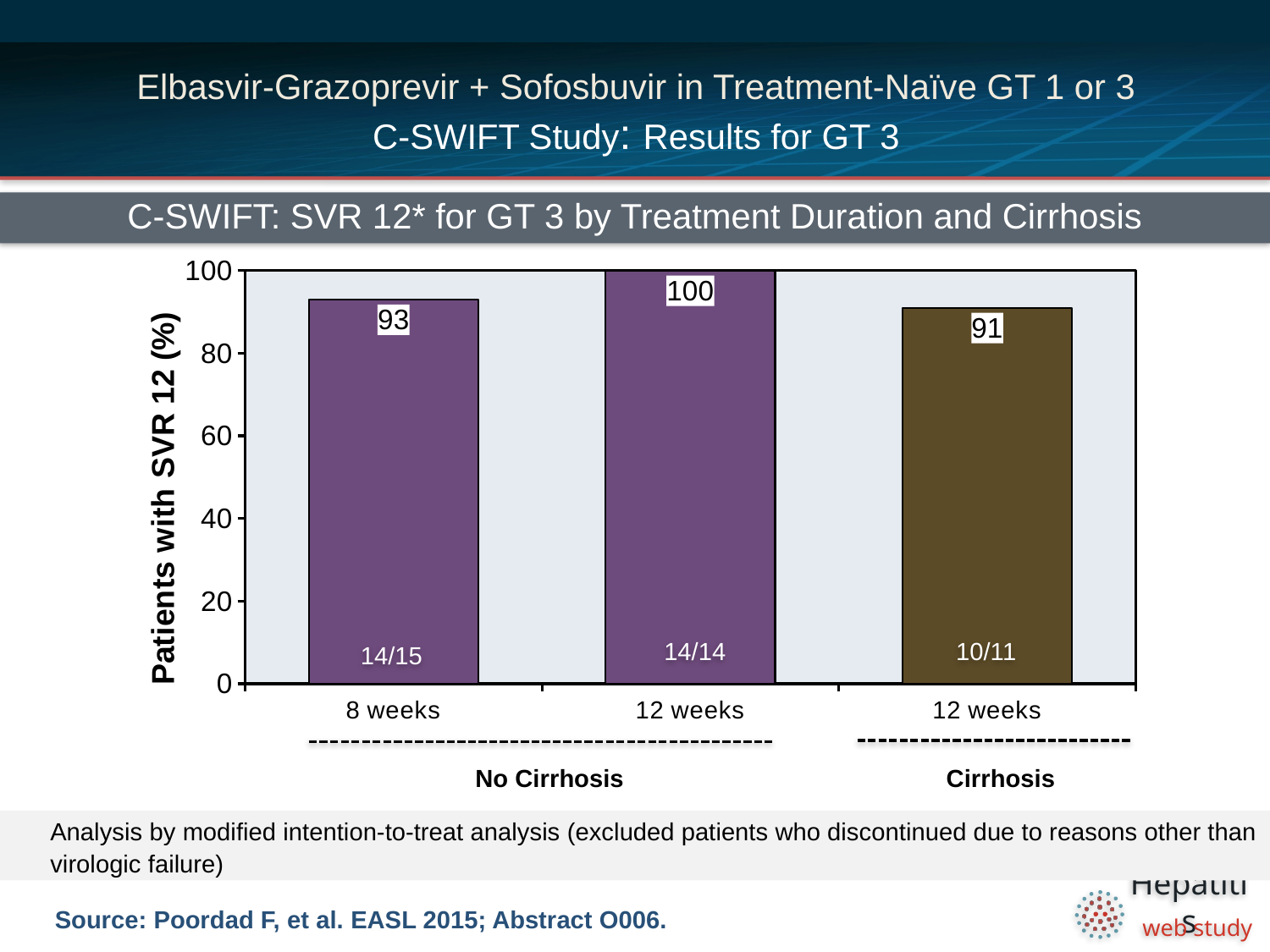
How many bars are shown in the chart? 3 Which group has the highest SVR 12 rate? 12 weeks, No Cirrhosis What is the SVR 12 rate for the 12 weeks, No Cirrhosis group? 100 What is the difference in SVR 12 rate between the 12 weeks No Cirrhosis group and the 12 weeks Cirrhosis group? 9 What is the SVR 12 rate for the 12 weeks, Cirrhosis group? 91 Is the SVR 12 rate for the 12 weeks Cirrhosis group greater or less than 80? greater What kind of chart is shown on the slide? Bar chart What is the SVR 12 rate for the 8 weeks, No Cirrhosis group? 93 Which has a higher SVR 12 rate: 8 weeks No Cirrhosis or 12 weeks Cirrhosis? 8 weeks No Cirrhosis Which group has the lowest SVR 12 rate? 12 weeks, Cirrhosis What patient fraction is shown for the 12 weeks, Cirrhosis bar? 10/11 What is the label of the y axis? Patients with SVR 12 (%)